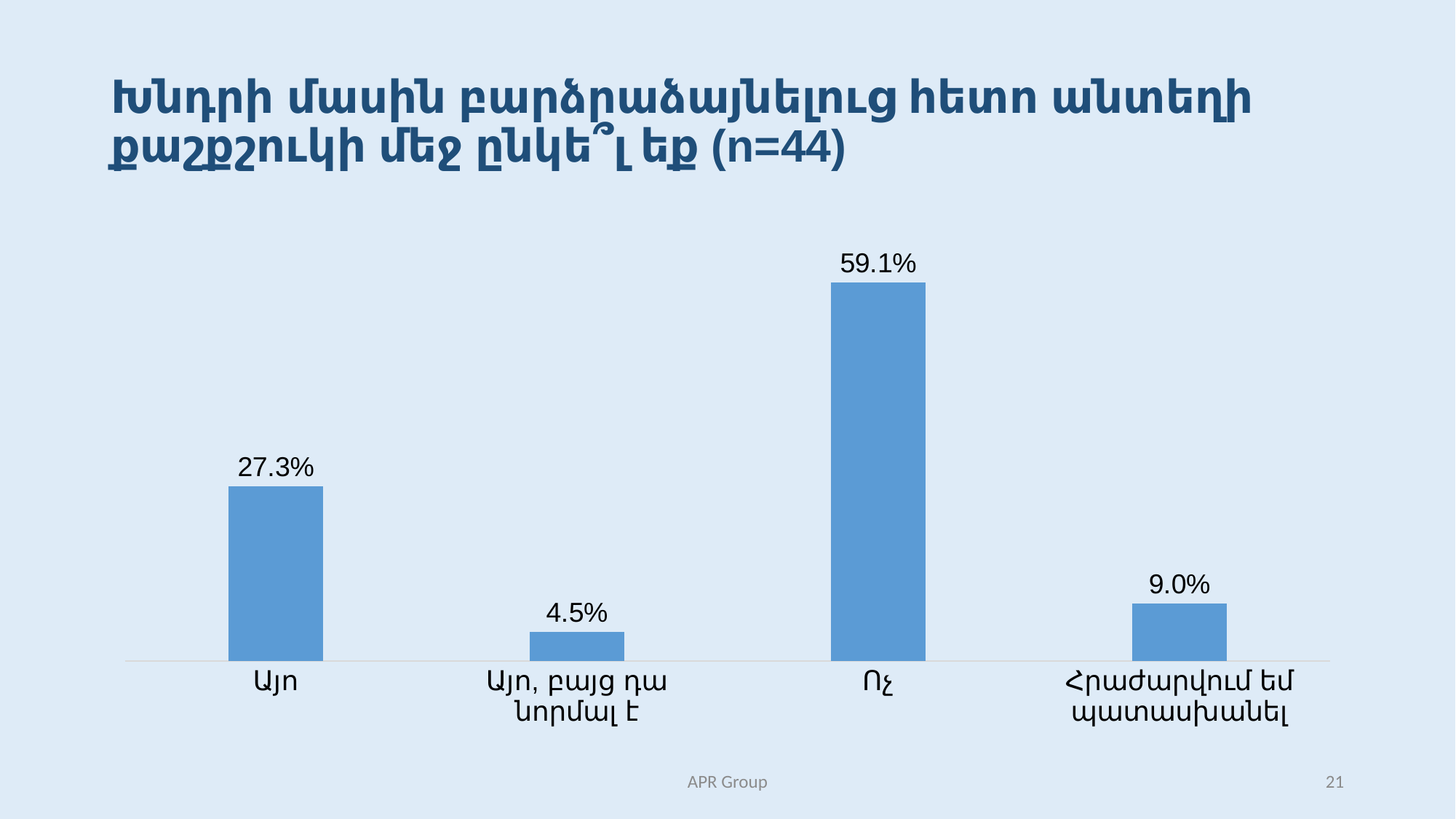
What is the difference between the values for "Ոչ" and "Այո"? 31.8% What kind of chart is shown on the slide? Bar chart What sample size (n) is stated in the chart title? n=44 Which category has the highest value? Ոչ Which category has the lowest value? Այո, բայց դա նորմալ է Which is larger, the value for "Այո" or the value for "Հրաժարվում եմ պատասխանել"? Այո What is the value for the category "Այո, բայց դա նորմալ է"? 4.5% What is the value for the category "Հրաժարվում եմ պատասխանել"? 9.0% What is the difference between the values for "Հրաժարվում եմ պատասխանել" and "Այո, բայց դա նորմալ է"? 4.5% How many categories are shown in the chart? 4 What is the value for the category "Այո"? 27.3% What is the value for the category "Ոչ"? 59.1%